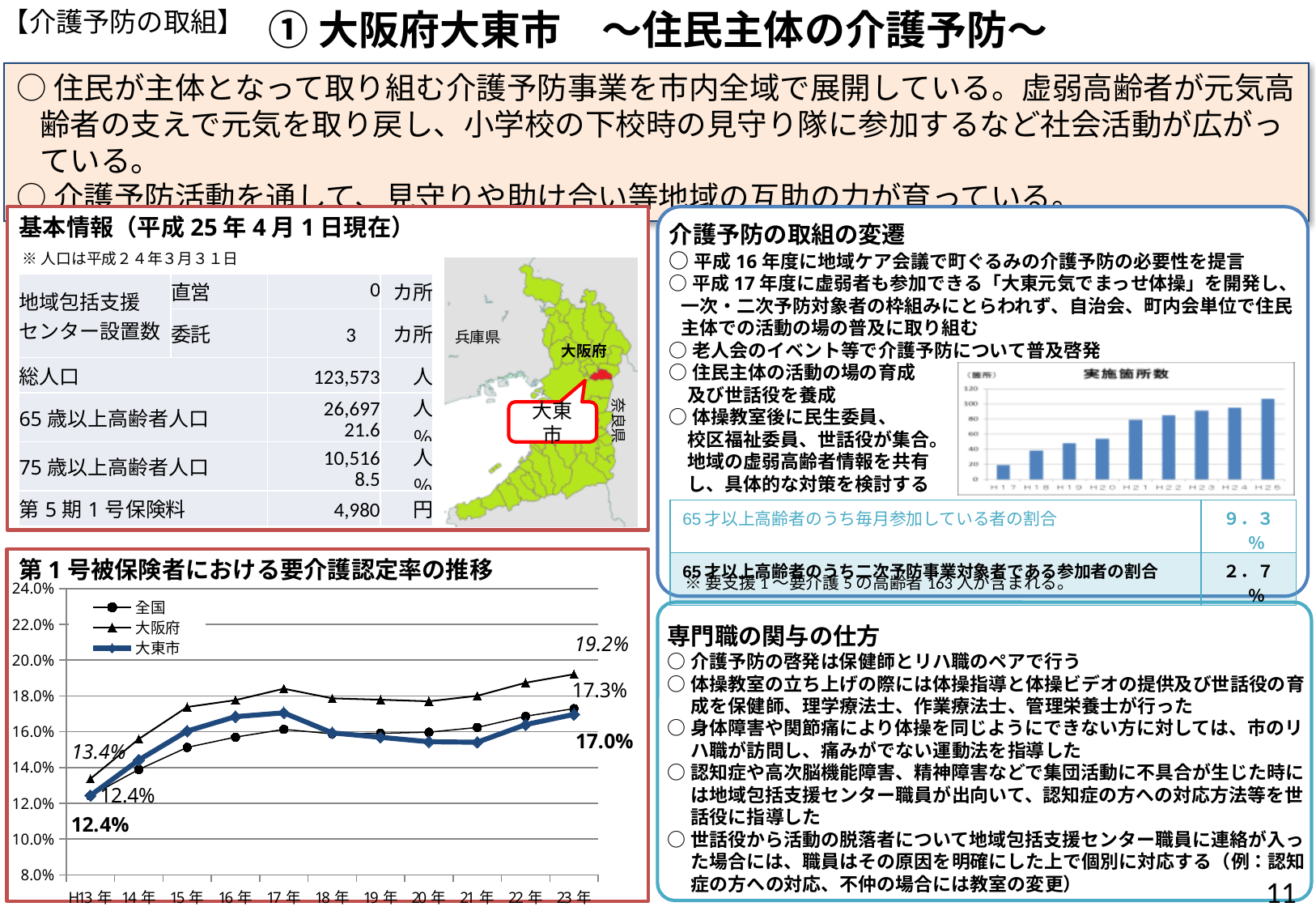
In the chart 第1号被保険者における要介護認定率の推移, what is the value for 大東市 at H13年? 12.4% What kind of chart is the chart titled 実施箇所数 on the right side of the slide? bar chart In the chart 実施箇所数, how many bars are shown? 9 In the chart 第1号被保険者における要介護認定率の推移, which series has the highest value at 23年? 大阪府 In the chart 第1号被保険者における要介護認定率の推移, what is the value for 大東市 at 23年? 17.0% In the chart 第1号被保険者における要介護認定率の推移, what is the value for 全国 at 23年? 17.3% In the chart 第1号被保険者における要介護認定率の推移, how many years are shown on the x axis? 11 In the chart 実施箇所数, do the values rise or fall from H17 to H25? rise In the chart 第1号被保険者における要介護認定率の推移, what is the value for 大阪府 at 23年? 19.2% In the chart 第1号被保険者における要介護認定率の推移, what is the difference between 大阪府 and 大東市 at 23年? 2.2 percentage points In the chart 第1号被保険者における要介護認定率の推移, how many series does the legend list? 3 What kind of chart is the chart titled 第1号被保険者における要介護認定率の推移? line chart